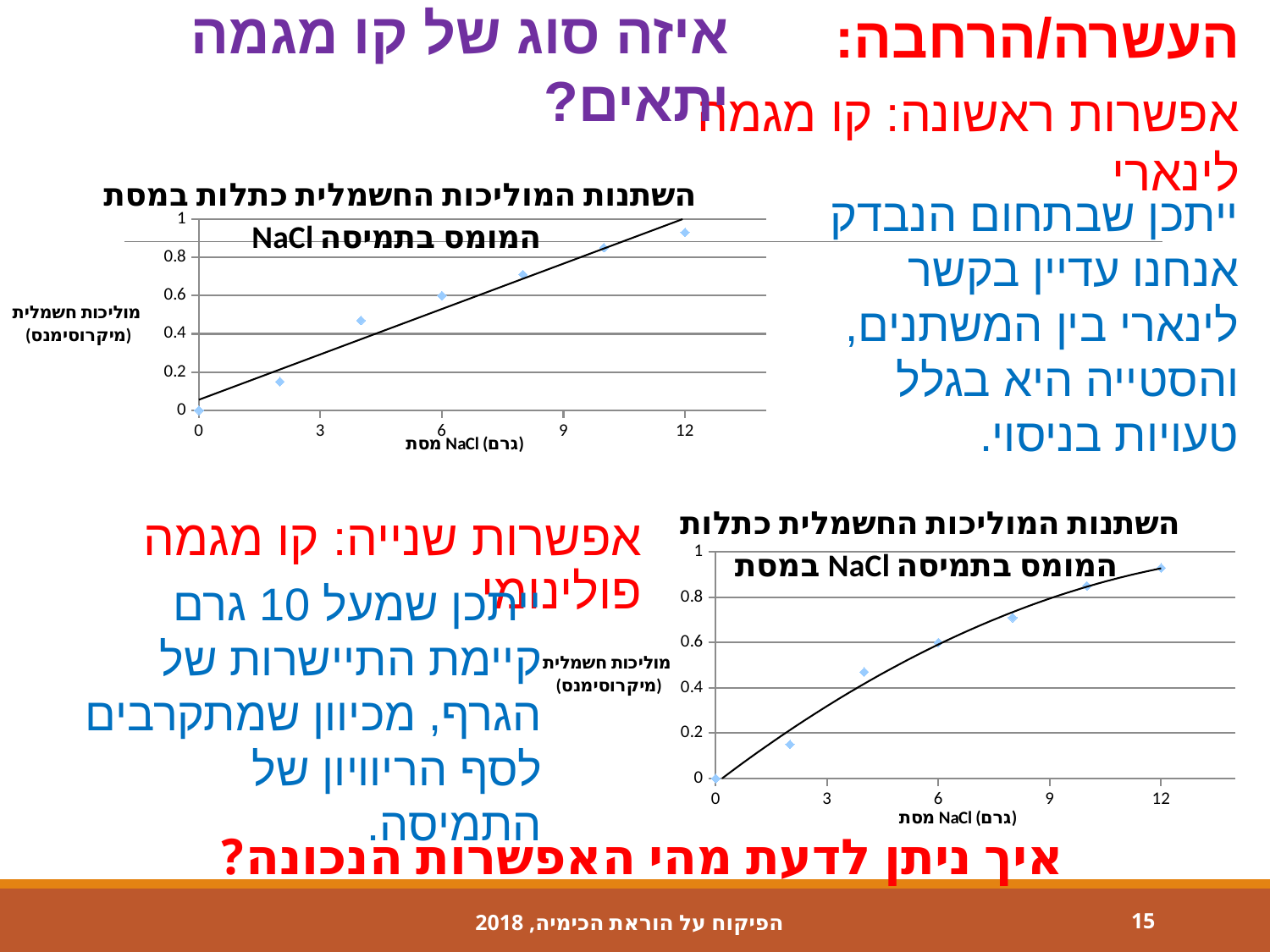
What is the x-axis label of the bottom chart? מסת NaCl (גרם) How many data points are plotted in the top chart? 7 What kind of chart is the top chart on the slide? scatter chart with a trendline In the bottom chart, is the value at 4 grams NaCl greater or less than 0.4? greater In the bottom chart, is the value at 8 grams NaCl greater or less than 0.8? less In the top chart, is the value at 2 grams NaCl greater or less than 0.2? less In the bottom chart, which has the larger conductivity value: 12 grams NaCl or 2 grams NaCl? 12 grams NaCl In the bottom chart, at which mass of NaCl is the conductivity highest? 12 In the top chart, do the values rise or fall as the mass of NaCl increases along the x axis? rise In the top chart, at which mass of NaCl is the conductivity lowest? 0 How do the trendlines differ between the top chart and the bottom chart? the top chart has a straight (linear) trendline, the bottom chart has a curved (polynomial) trendline